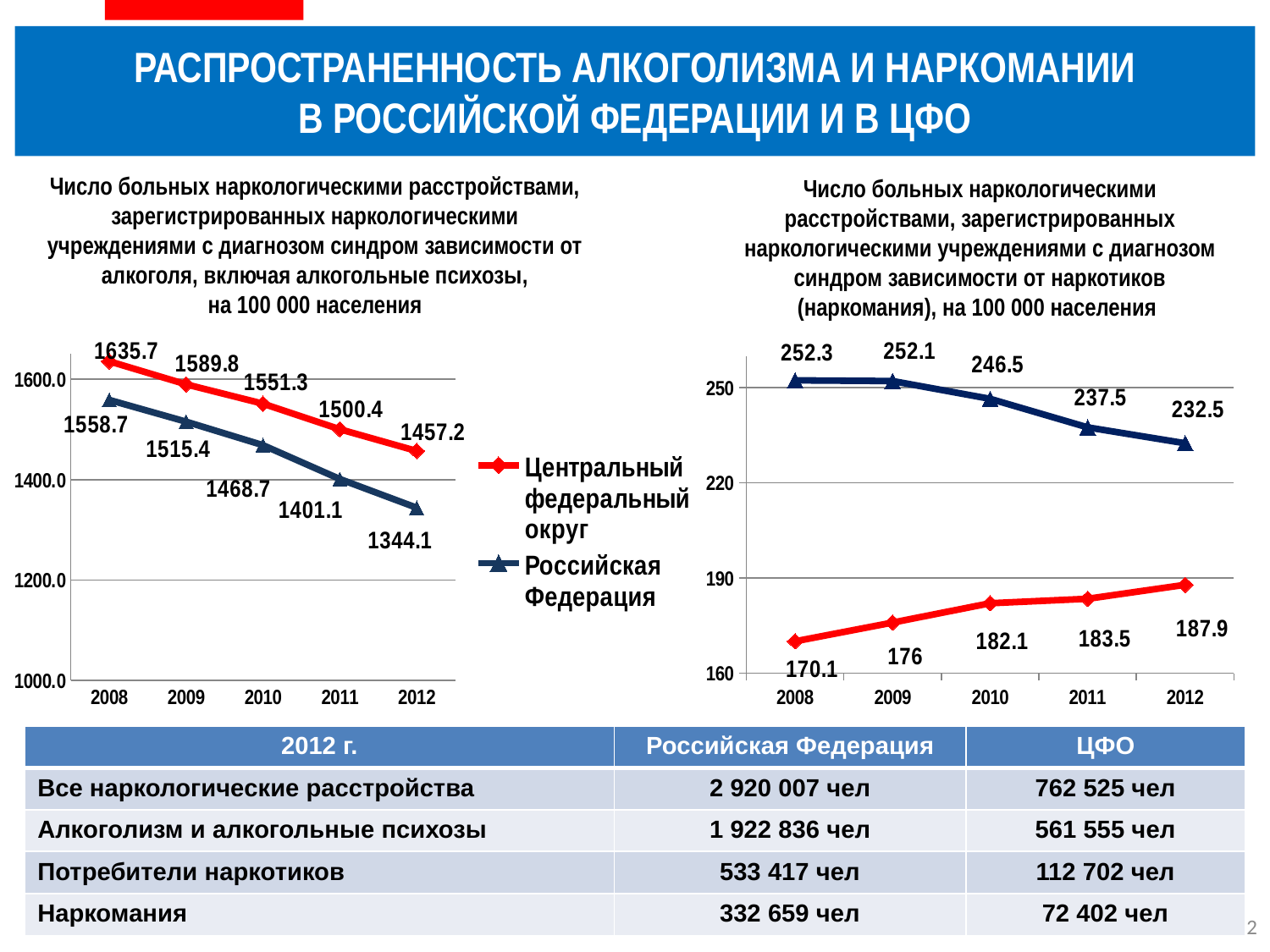
What kind of chart is the left chart? line chart On the left chart, how many series does the legend list? 2 On the left chart (alcohol dependence per 100 000), what is the value for Российская Федерация in 2012? 1344.1 On the right chart, do the values of the lower (red) line rise or fall from 2008 to 2012? rise On the right chart, what is the difference between the upper line and the lower line in 2008? 82.2 On the right chart (drug dependence per 100 000), what is the value of the upper (dark blue) line in 2010? 246.5 On the left chart (alcohol dependence per 100 000), what is the value for Центральный федеральный округ in 2008? 1635.7 On the right chart (drug dependence per 100 000), what is the value of the lower (red) line in 2012? 187.9 On the right chart, how many years are plotted on the x axis? 5 On the left chart, do the values for Российская Федерация rise or fall from 2008 to 2012? fall On the left chart, which year has the lowest value for Центральный федеральный округ? 2012 On the left chart, what is the difference between the Центральный федеральный округ and Российская Федерация values in 2011? 99.3